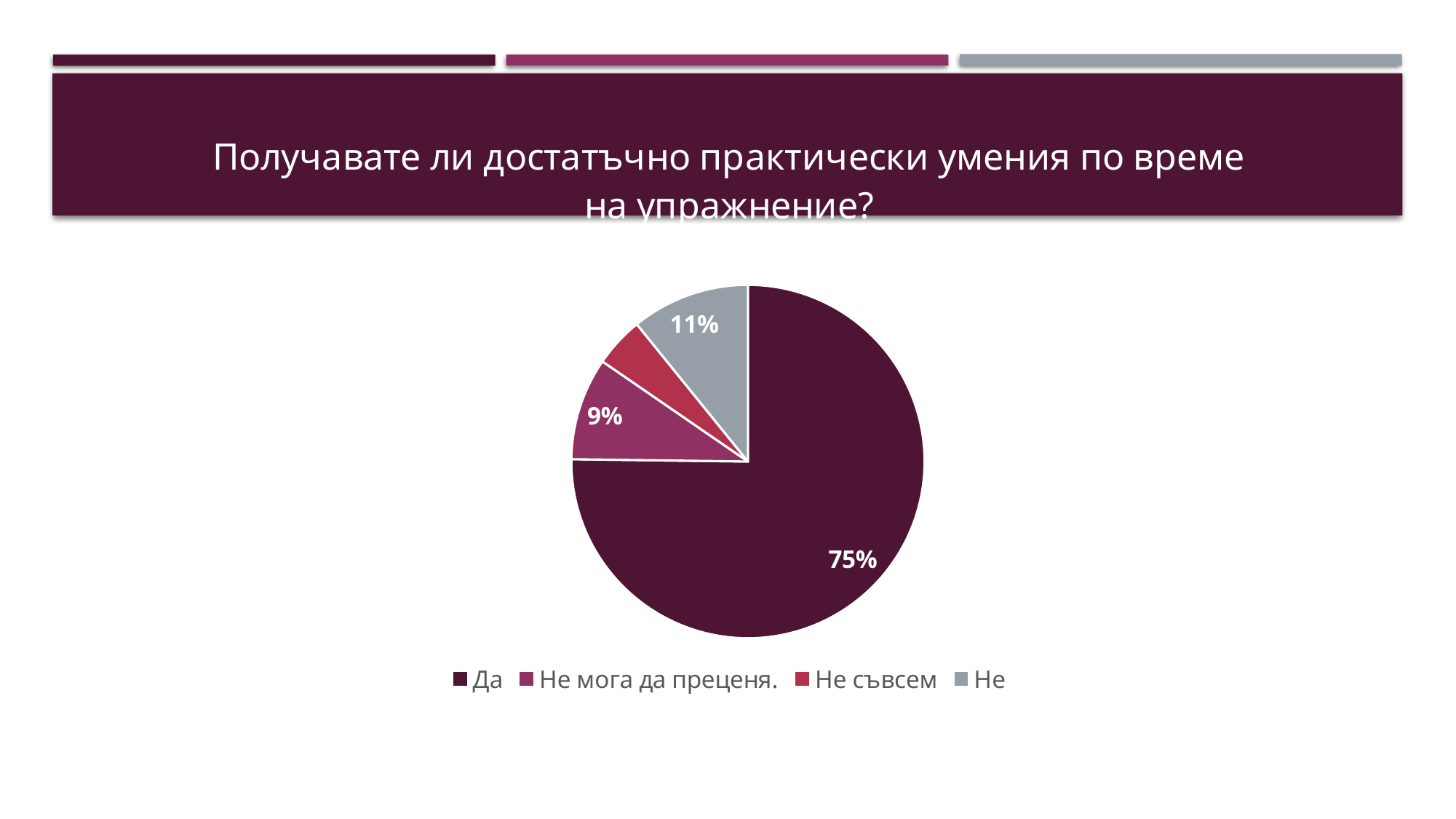
Which is larger, the share for "Не" or the share for "Не мога да преценя."? Не What kind of chart is shown on the slide? pie chart What share of the pie does "Да" have? 75% What is the difference between the shares for "Не" and "Не мога да преценя."? 2% Which category has the largest slice of the pie? Да What is the difference between the shares for "Да" and "Не"? 64% How many entries does the legend list? 4 What share of the pie does "Не" have? 11% How many categories does the pie chart have? 4 What is the title of the chart on the slide? Получавате ли достатъчно практически умения по време на упражнение? Which category has the smallest slice of the pie? Не съвсем What share of the pie does "Не мога да преценя." have? 9%